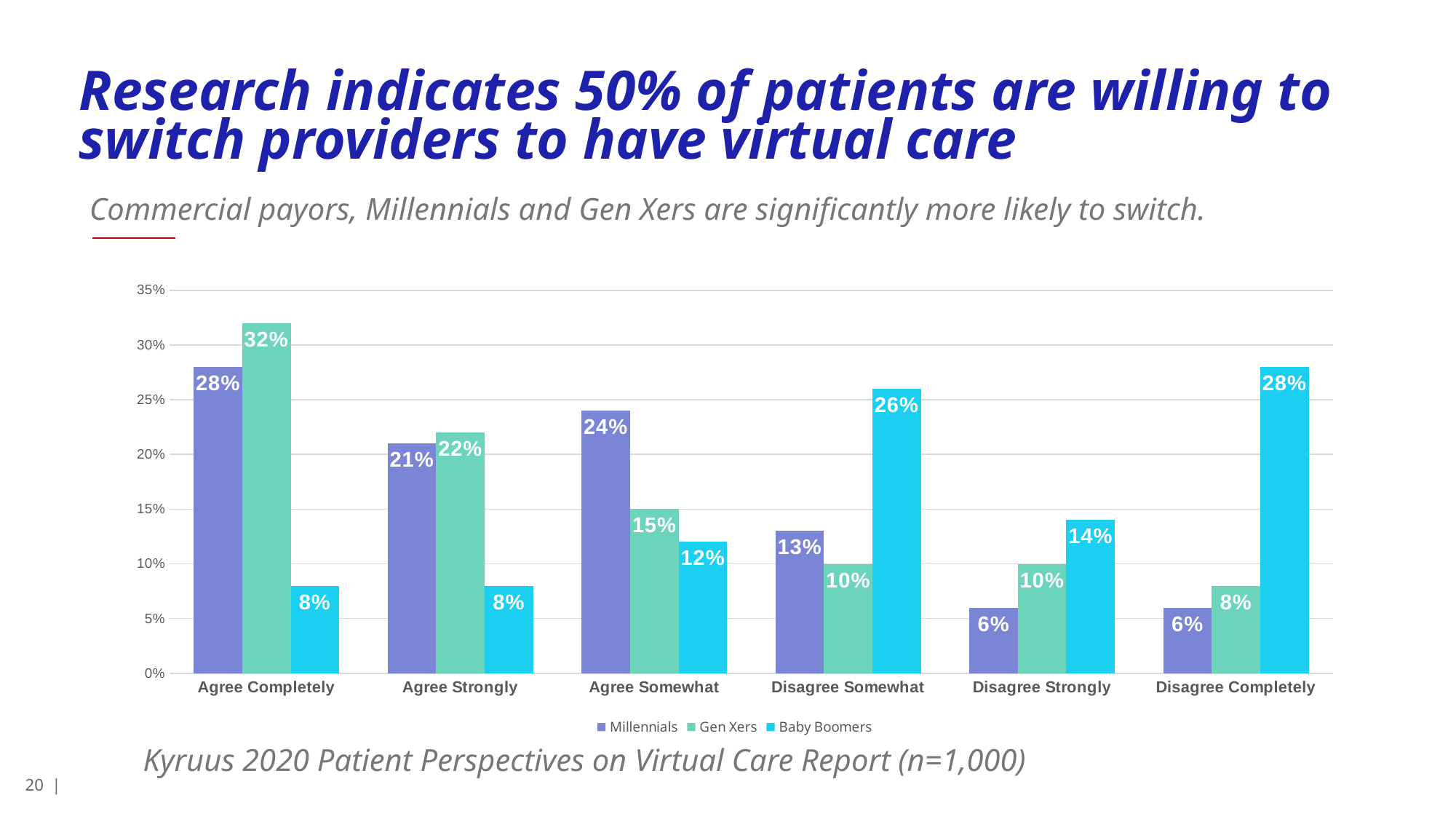
Do the Millennials values rise or fall from Agree Somewhat to Disagree Completely? Fall How many series does the legend list? 3 Which category has the highest value for Baby Boomers? Disagree Completely What is the value for Baby Boomers in the Disagree Somewhat category? 26% What is the value for Millennials in the Agree Somewhat category? 24% What is the difference between the Gen Xers and Millennials values in the Agree Completely category? 4% Is the value for Baby Boomers in Disagree Somewhat greater or less than 25%? greater Which is larger in the Agree Strongly category: Millennials or Gen Xers? Gen Xers Which category has the lowest value for Gen Xers? Disagree Completely What kind of chart is shown on the slide? Bar chart How many categories are shown on the x axis? 6 What is the value for Gen Xers in the Agree Completely category? 32%